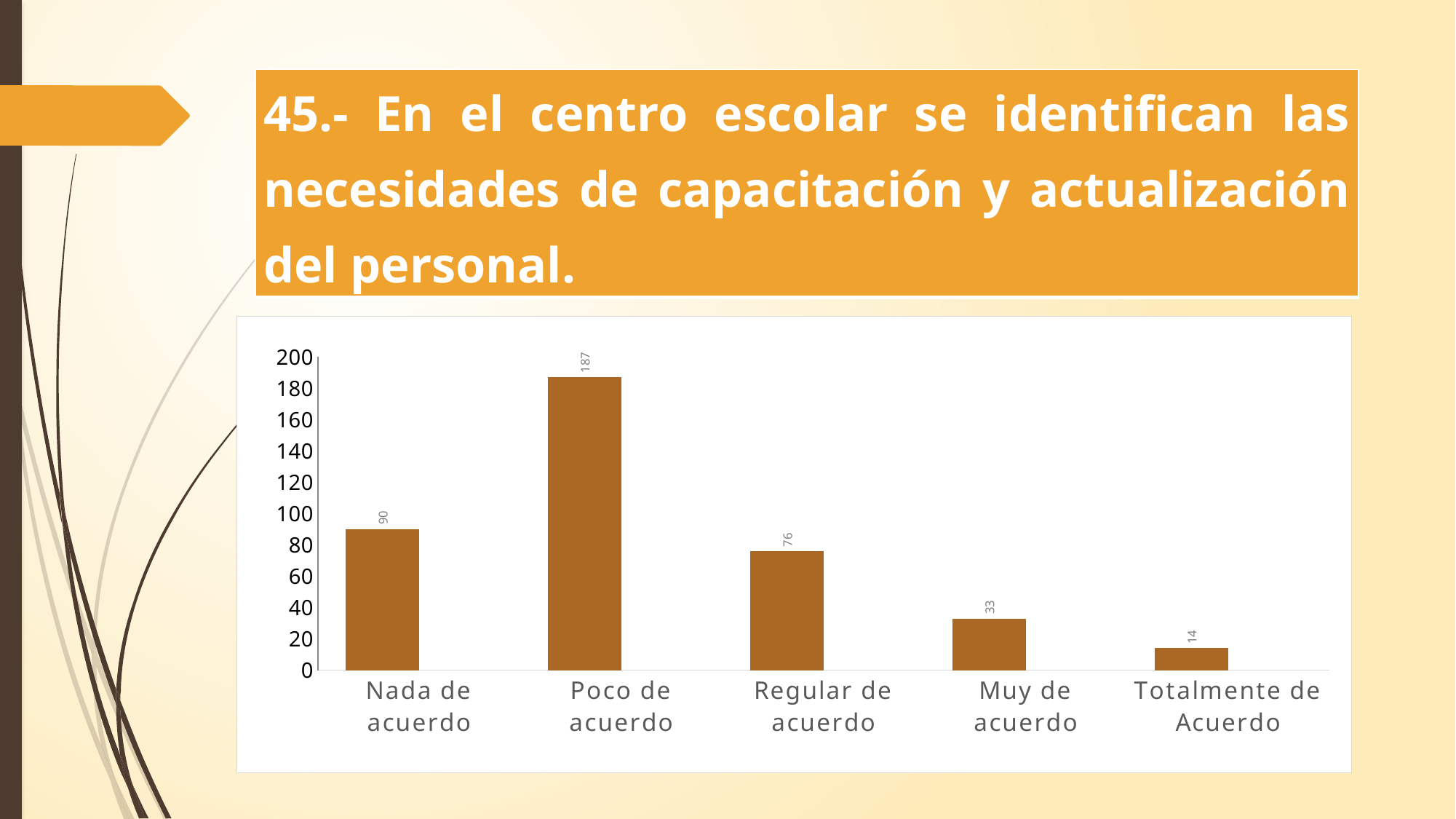
Is the value for "Muy de acuerdo" greater or less than 40? less What is the total of all five values shown in the chart? 400 How many categories are shown on the x axis? 5 What is the difference between the values for "Regular de acuerdo" and "Muy de acuerdo"? 43 What is the value for "Totalmente de Acuerdo"? 14 What is the value for "Nada de acuerdo"? 90 What is the value for "Poco de acuerdo"? 187 Which is larger, the value for "Nada de acuerdo" or the value for "Regular de acuerdo"? Nada de acuerdo What is the difference between the values for "Poco de acuerdo" and "Nada de acuerdo"? 97 Which category has the highest value? Poco de acuerdo What kind of chart is shown on the slide? Bar chart Which category has the lowest value? Totalmente de Acuerdo